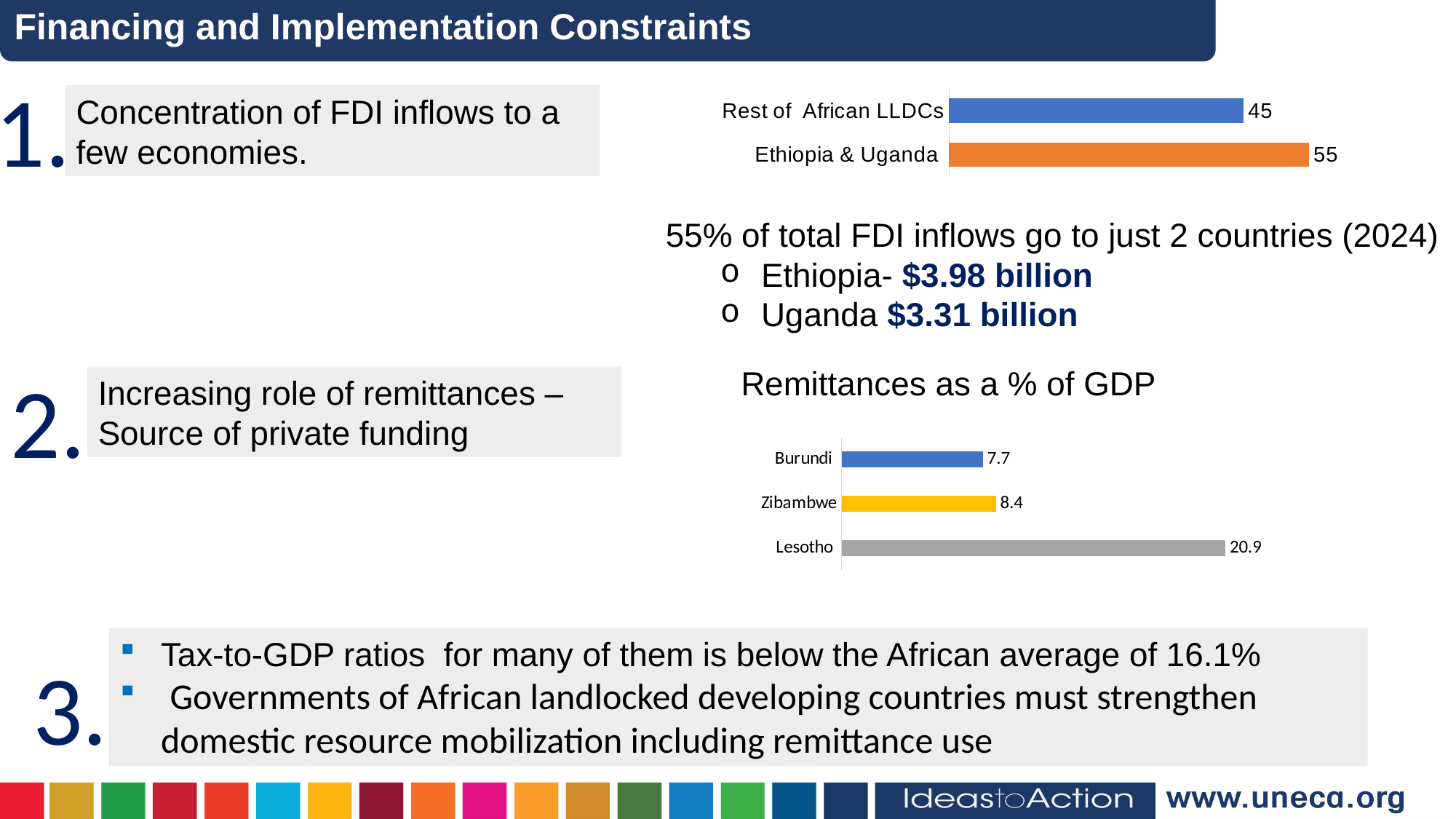
What kind of chart is the top-right chart on the slide? Bar chart In the top-right chart on the slide, which category has the higher value? Ethiopia & Uganda In the 'Remittances as a % of GDP' chart, what is the value for Burundi? 7.7 In the 'Remittances as a % of GDP' chart, what is the difference between the values for Lesotho and Zibambwe? 12.5 In the top-right chart on the slide, how many bars are plotted? 2 In the 'Remittances as a % of GDP' chart, how many countries are plotted? 3 In the top-right chart on the slide, what is the value for Ethiopia & Uganda? 55 In the top-right chart on the slide, what is the value for Rest of African LLDCs? 45 In the 'Remittances as a % of GDP' chart, what is the value for Lesotho? 20.9 In the 'Remittances as a % of GDP' chart, which country has the highest value? Lesotho In the top-right chart on the slide, what is the difference between the values for Ethiopia & Uganda and Rest of African LLDCs? 10 In the 'Remittances as a % of GDP' chart, which country has the lowest value? Burundi